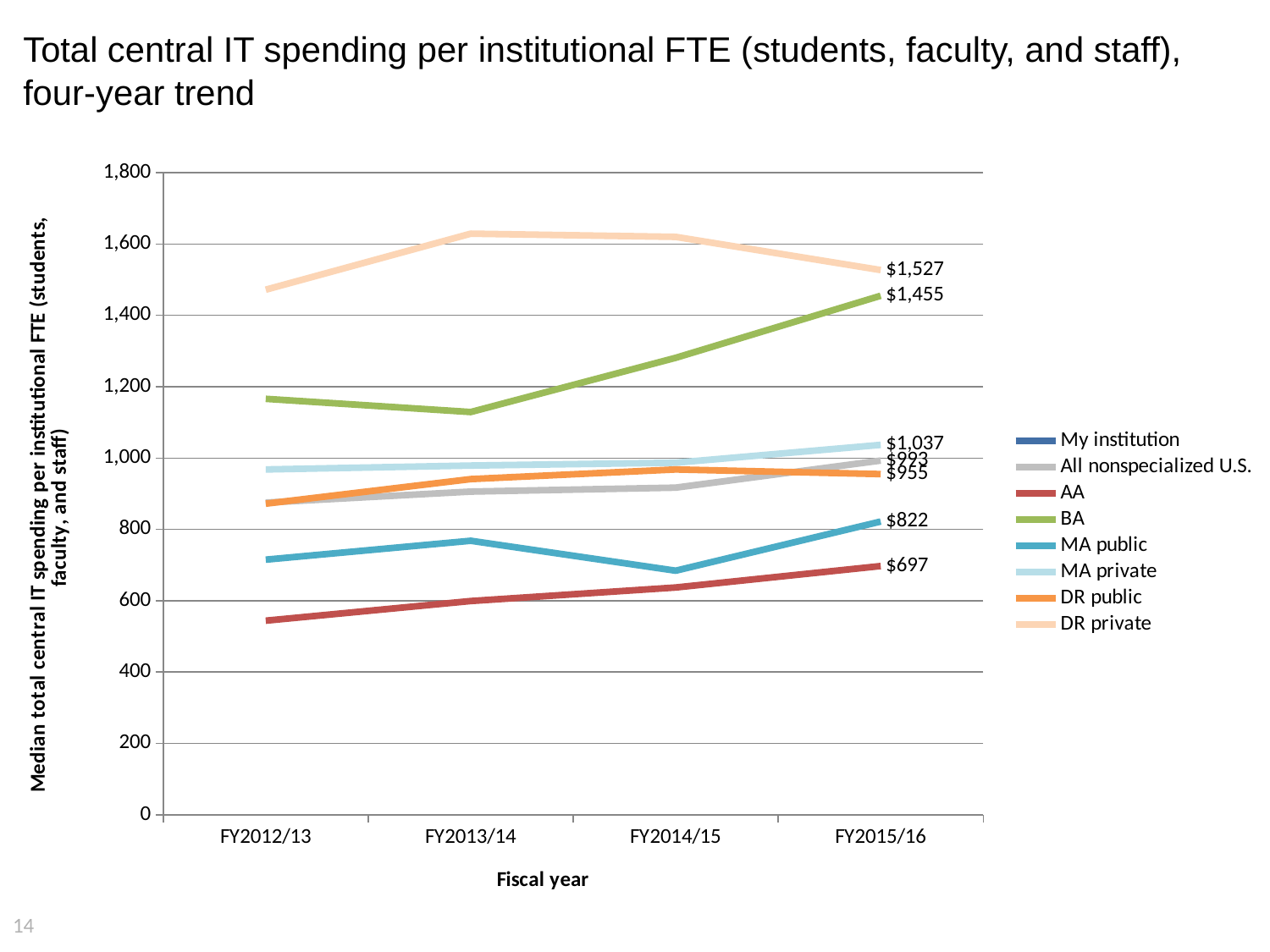
Which plotted series has the lowest value in FY2015/16? AA What is the value for MA public in FY2015/16? $822 How many fiscal years are shown on the x axis? 4 What is the value for AA in FY2015/16? $697 What is the difference between DR private and BA in FY2015/16? $72 Is the value for AA in FY2012/13 greater or less than 600? less How many series does the legend list? 8 Which series has the highest value in FY2015/16? DR private What kind of chart is shown on the slide? line chart What is the value for BA in FY2015/16? $1,455 What is the value for MA private in FY2015/16? $1,037 What is the value for DR private in FY2015/16? $1,527